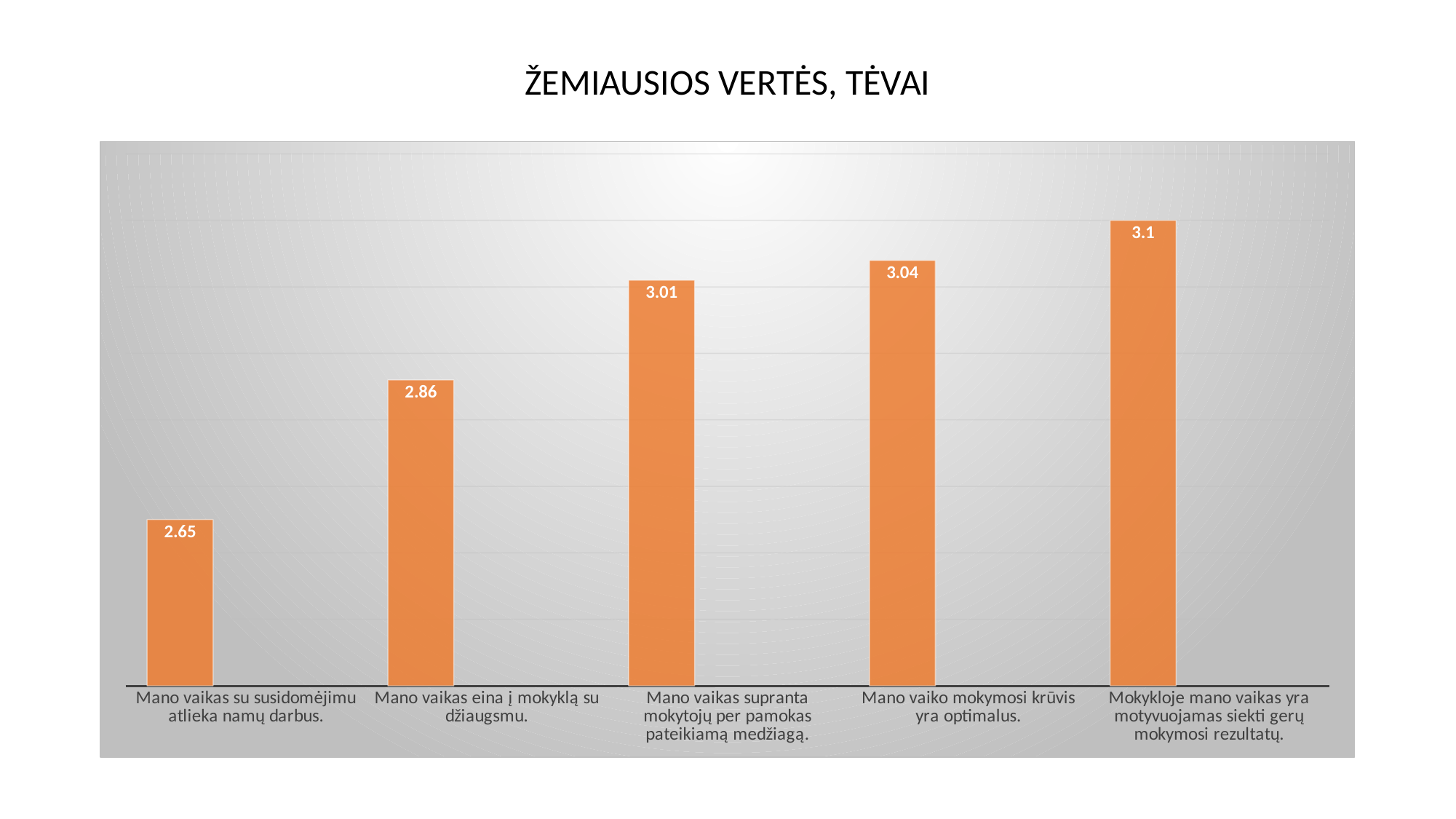
What is the value for "Mano vaikas supranta mokytojų per pamokas pateikiamą medžiagą."? 3.01 What is the value for "Mokykloje mano vaikas yra motyvuojamas siekti gerų mokymosi rezultatų."? 3.1 How many categories are shown in the chart? 5 Do the values rise or fall from left to right across the categories? Rise Which is larger: the value for "Mano vaikas eina į mokyklą su džiaugsmu." or for "Mano vaikas supranta mokytojų per pamokas pateikiamą medžiagą."? Mano vaikas supranta mokytojų per pamokas pateikiamą medžiagą. What is the title of the chart? ŽEMIAUSIOS VERTĖS, TĖVAI Which category has the lowest value? Mano vaikas su susidomėjimu atlieka namų darbus. What is the value for "Mano vaikas eina į mokyklą su džiaugsmu."? 2.86 Which category has the highest value? Mokykloje mano vaikas yra motyvuojamas siekti gerų mokymosi rezultatų. What kind of chart is shown on the slide? Bar chart What is the value for "Mano vaikas su susidomėjimu atlieka namų darbus."? 2.65 What is the difference between the values for "Mano vaiko mokymosi krūvis yra optimalus." and "Mano vaikas su susidomėjimu atlieka namų darbus."? 0.39